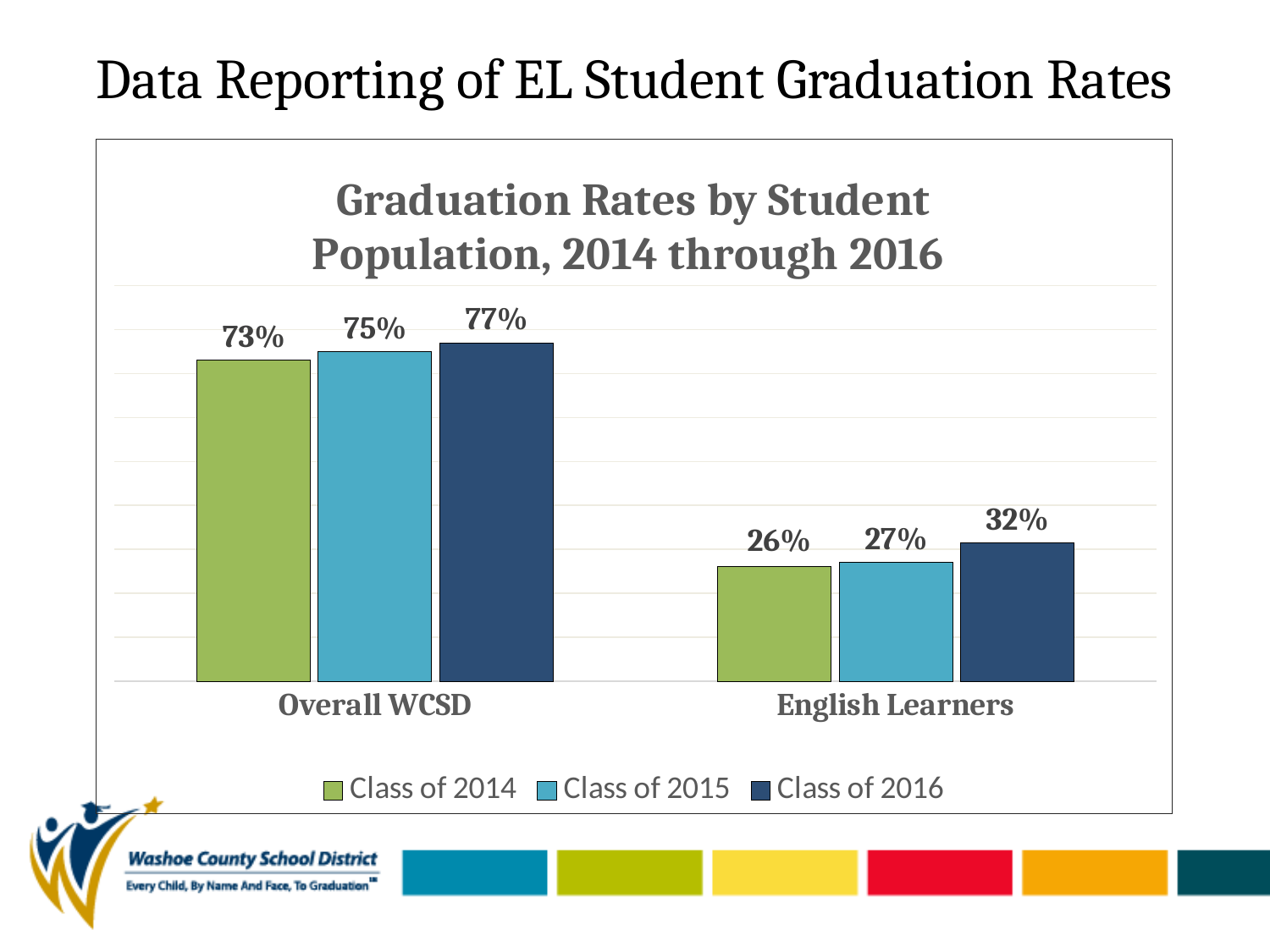
What is the difference between the Class of 2016 and Class of 2014 graduation rates for English Learners? 6% What is the difference between the Overall WCSD and English Learners graduation rates for the Class of 2016? 45% Which class year has the highest graduation rate for Overall WCSD? Class of 2016 What is the graduation rate for English Learners for the Class of 2015? 27% Do the graduation rates for English Learners rise or fall from the Class of 2014 to the Class of 2016? Rise How many series does the legend list? 3 What kind of chart is shown on the slide? Bar chart Which is larger: the Class of 2015 rate for Overall WCSD or the Class of 2015 rate for English Learners? Overall WCSD What is the graduation rate for Overall WCSD for the Class of 2014? 73% Which class year has the lowest graduation rate for English Learners? Class of 2014 What is the graduation rate for English Learners for the Class of 2016? 32% How many student population categories are shown on the x axis? 2